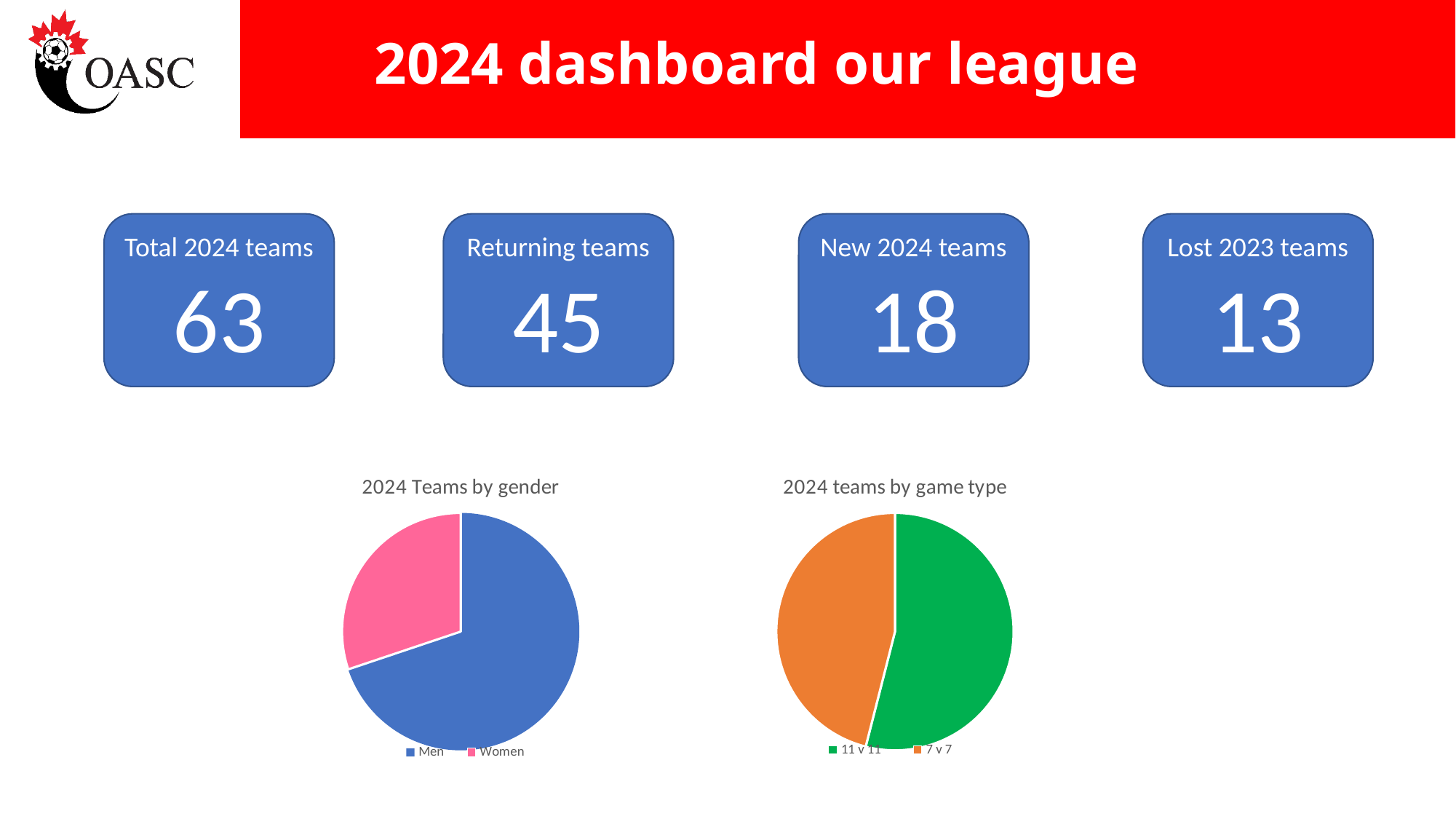
How many entries does the legend of the "2024 teams by game type" chart list? 2 In the "2024 Teams by gender" chart, which category has the largest slice? Men What kind of chart is the "2024 Teams by gender" chart? pie chart In the "2024 Teams by gender" chart, which category has the smallest slice? Women What kind of chart is the "2024 teams by game type" chart? pie chart In the "2024 Teams by gender" chart, what colour is the Women slice? pink In the "2024 Teams by gender" chart, which slice is larger, Men or Women? Men How many slices does the "2024 teams by game type" pie chart have? 2 How many slices does the "2024 Teams by gender" pie chart have? 2 What are the legend entries of the "2024 teams by game type" chart? 11 v 11 and 7 v 7